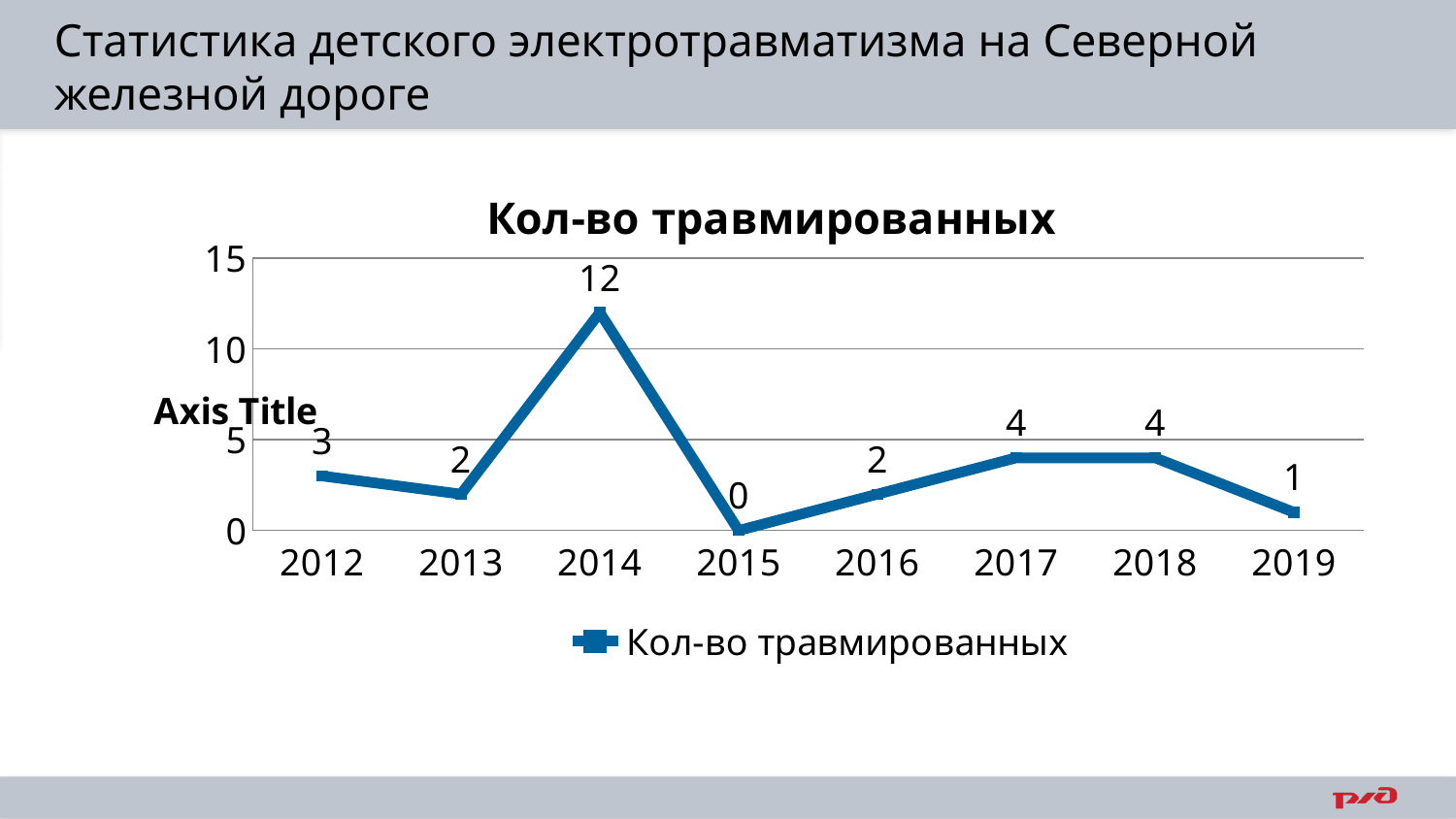
What is the value for 2014? 12 Which year has the lowest value? 2015 What is the value for 2012? 3 What kind of chart is this? line chart Which year has the highest value? 2014 What is the title of the chart? Кол-во травмированных How many years are shown on the x axis? 8 Is the value for 2014 greater or less than 10? greater How many series does the legend list? 1 What is the difference between the values for 2014 and 2013? 10 What is the value for 2019? 1 Which is larger, the value for 2017 or the value for 2019? 2017